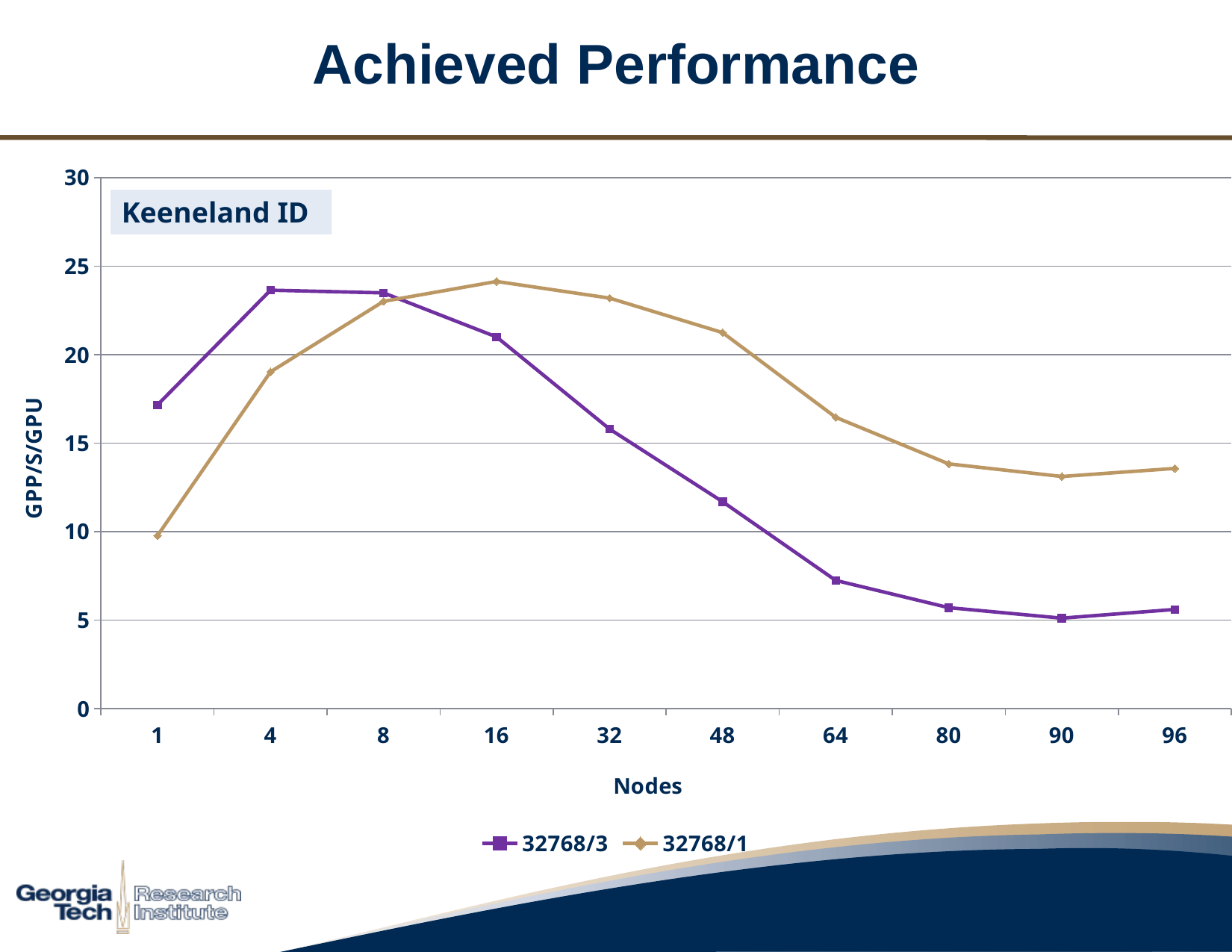
Is the value for 32768/1 at 48 nodes greater or less than 20? greater At 1 node, which series has the higher value, 32768/3 or 32768/1? 32768/3 How many node counts are plotted along the x axis? 10 What is the label on the y axis? GPP/S/GPU Is the value for 32768/3 at 64 nodes greater or less than 10? less For the 32768/1 series, at which node count is the value lowest? 1 For the 32768/1 series, at which node count is the value highest? 16 At 64 nodes, which series has the higher value, 32768/3 or 32768/1? 32768/1 How many series does the legend list? 2 What kind of chart is shown on the slide? line chart Does the 32768/3 series rise or fall from 16 nodes to 90 nodes? fall